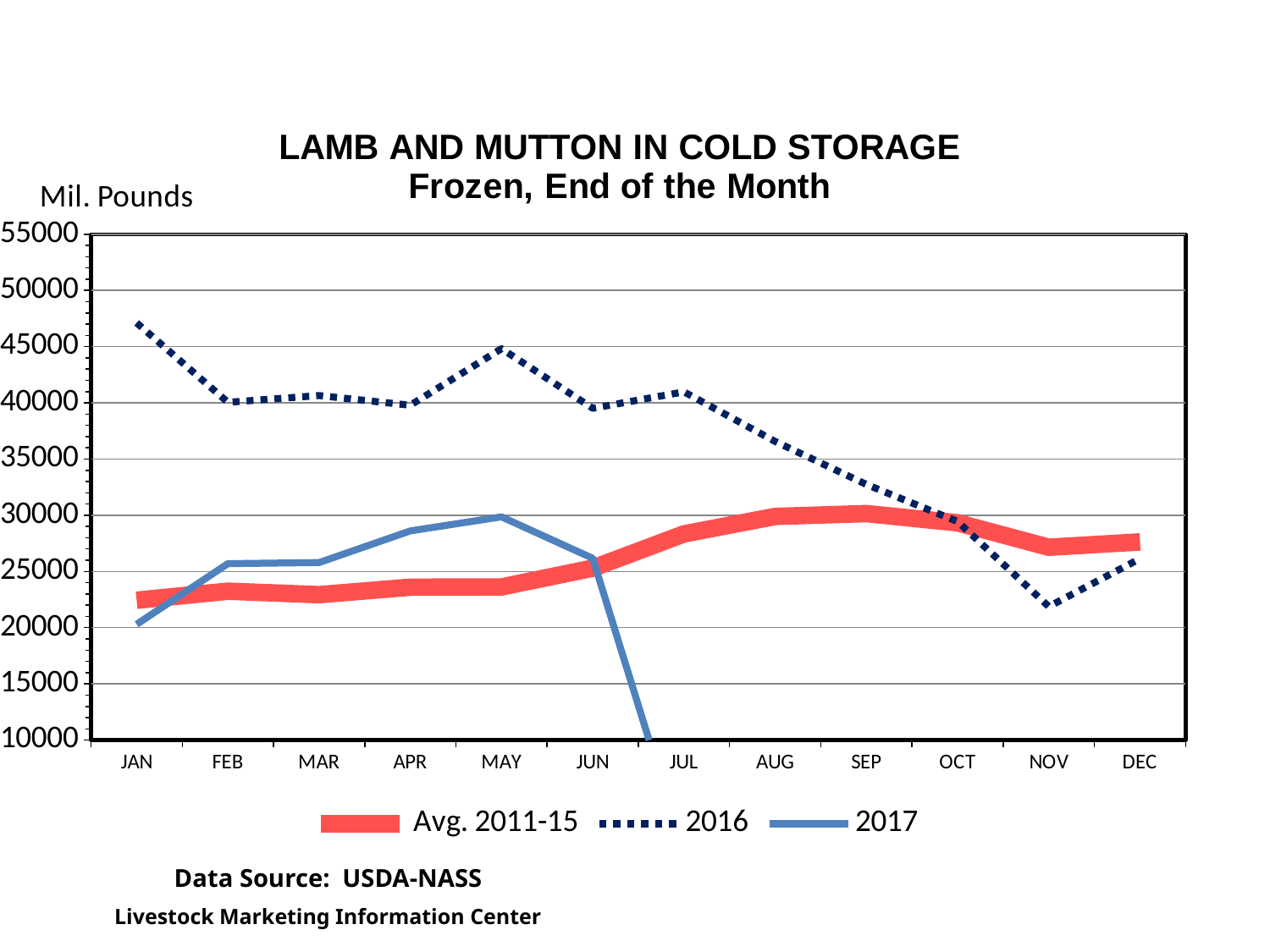
Is the 2016 value for NOV greater or less than 25000? less In APR, which is larger: the 2017 value or the Avg. 2011-15 value? 2017 How many series does the legend list? 3 Does the 2016 series rise or fall from JUL to NOV? fall In which month is the 2016 series lowest? NOV Is the 2017 value for MAY greater or less than 25000? greater Is the 2016 value for JAN greater or less than 45000? greater How many months are shown along the x axis? 12 In which month is the 2016 series highest? JAN What unit is shown on the y axis label? Mil. Pounds What kind of chart is shown on the slide? line chart